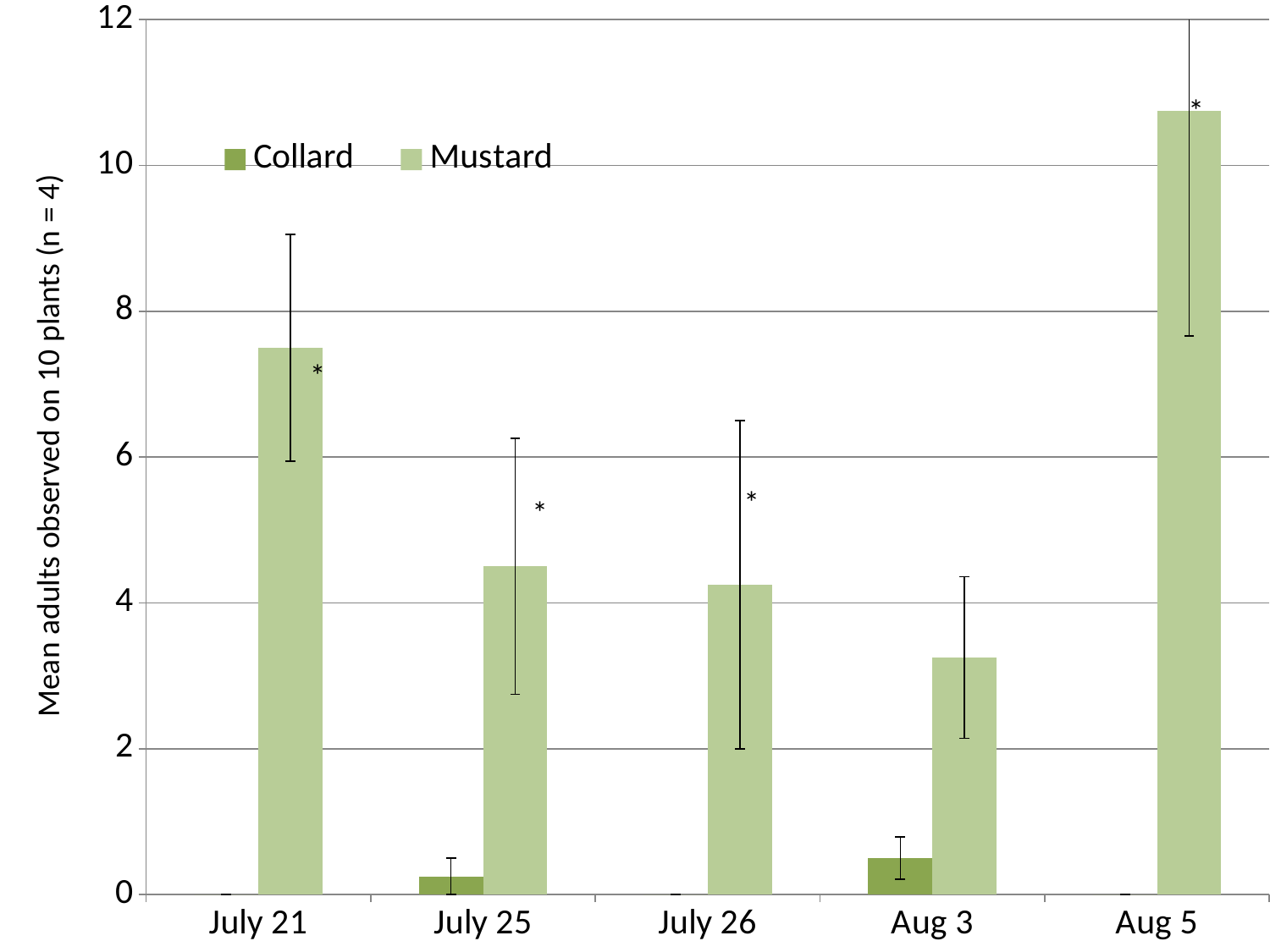
How many series does the legend list? 2 Which is larger, the Mustard value for July 21 or the Mustard value for Aug 3? July 21 Is the Collard value for Aug 3 greater or less than 2? less What is the title of the y axis? Mean adults observed on 10 plants (n = 4) How many dates are shown on the x axis? 5 On which date is the Mustard value highest? Aug 5 Is the Mustard value for July 21 greater or less than 8? less Do the Mustard values rise or fall from July 21 to Aug 3? fall Is the Mustard value for Aug 3 greater or less than 2? greater What kind of chart is shown on the slide? bar chart On which date is the Mustard value lowest? Aug 3